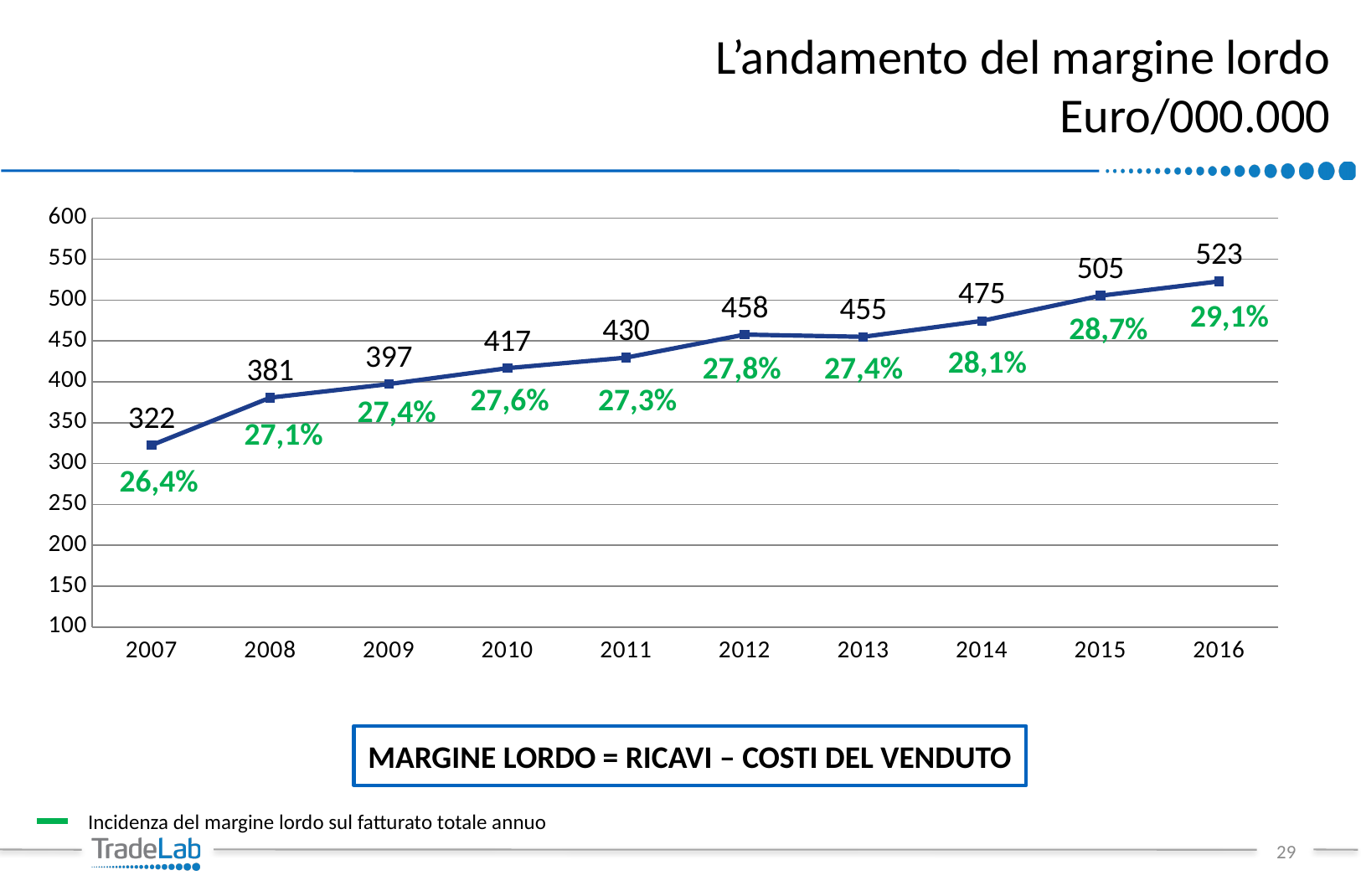
What percentage incidence of gross margin on total annual turnover is shown for 2007? 26,4% Which year has the highest gross margin value? 2016 What is the title of the chart on the slide? L'andamento del margine lordo Euro/000.000 What is the difference between the gross margin values for 2016 and 2007? 201 What is the gross margin (margine lordo) value for 2010? 417 Which year has the lowest gross margin value? 2007 Does the gross margin value generally rise or fall from 2007 to 2016? rise Is the gross margin value for 2009 greater or less than 400? less Which year has the larger gross margin value, 2012 or 2013? 2012 What is the gross margin value for 2013? 455 How many years are shown on the x axis? 10 What kind of chart is shown on the slide? line chart